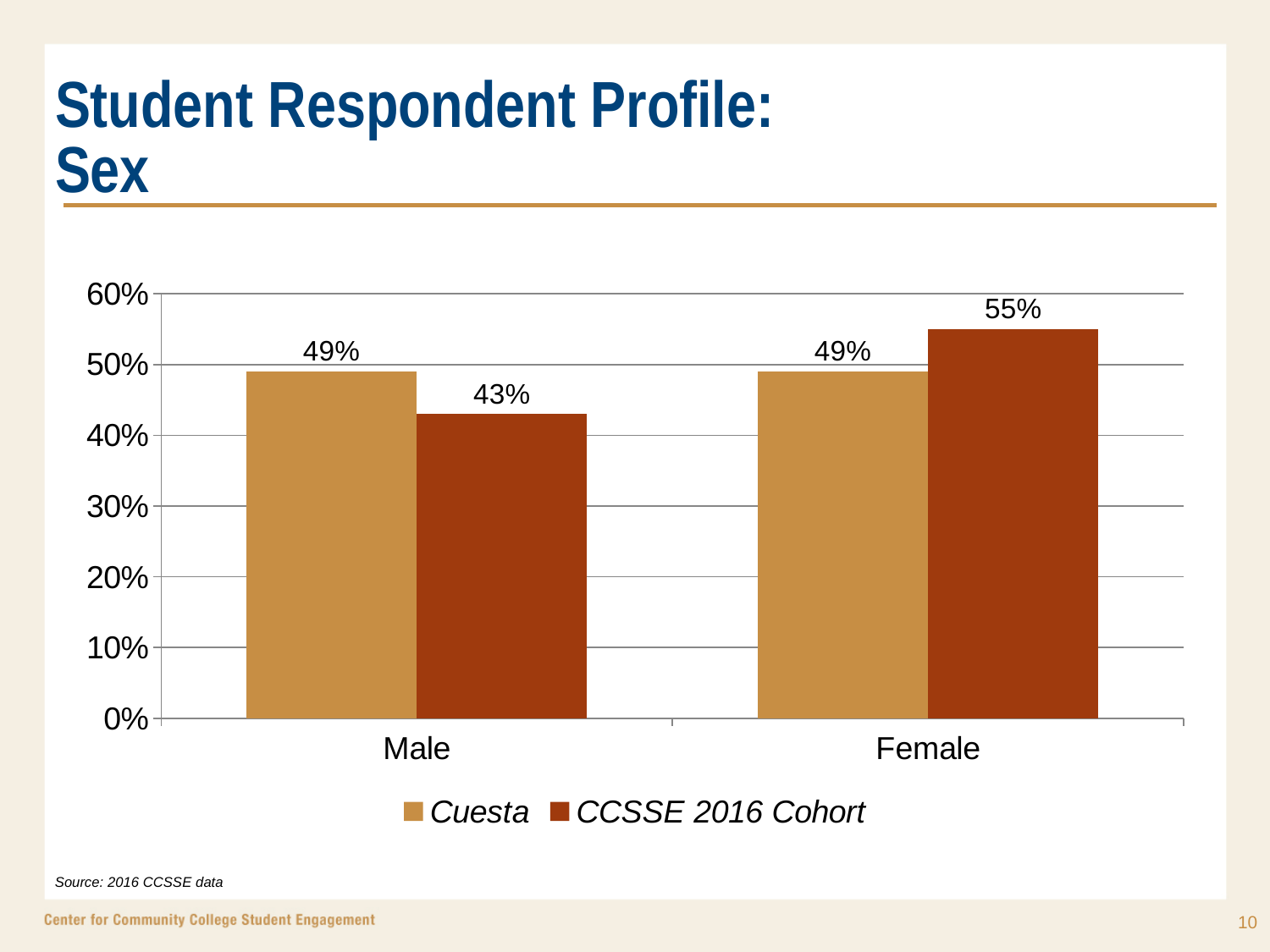
For Female, which is larger: the Cuesta value or the CCSSE 2016 Cohort value? CCSSE 2016 Cohort What is the CCSSE 2016 Cohort value for Female? 55% What is the difference between the Cuesta and CCSSE 2016 Cohort values for Male? 6% Which category has the highest CCSSE 2016 Cohort value? Female How many series does the legend list? 2 What kind of chart is shown on the slide? bar chart Which category has the lowest CCSSE 2016 Cohort value? Male What is the CCSSE 2016 Cohort value for Male? 43% What is the Cuesta value for Male? 49% Is the CCSSE 2016 Cohort value for Male greater or less than 50%? less How many categories are shown on the x axis? 2 What is the difference between the CCSSE 2016 Cohort values for Female and Male? 12%